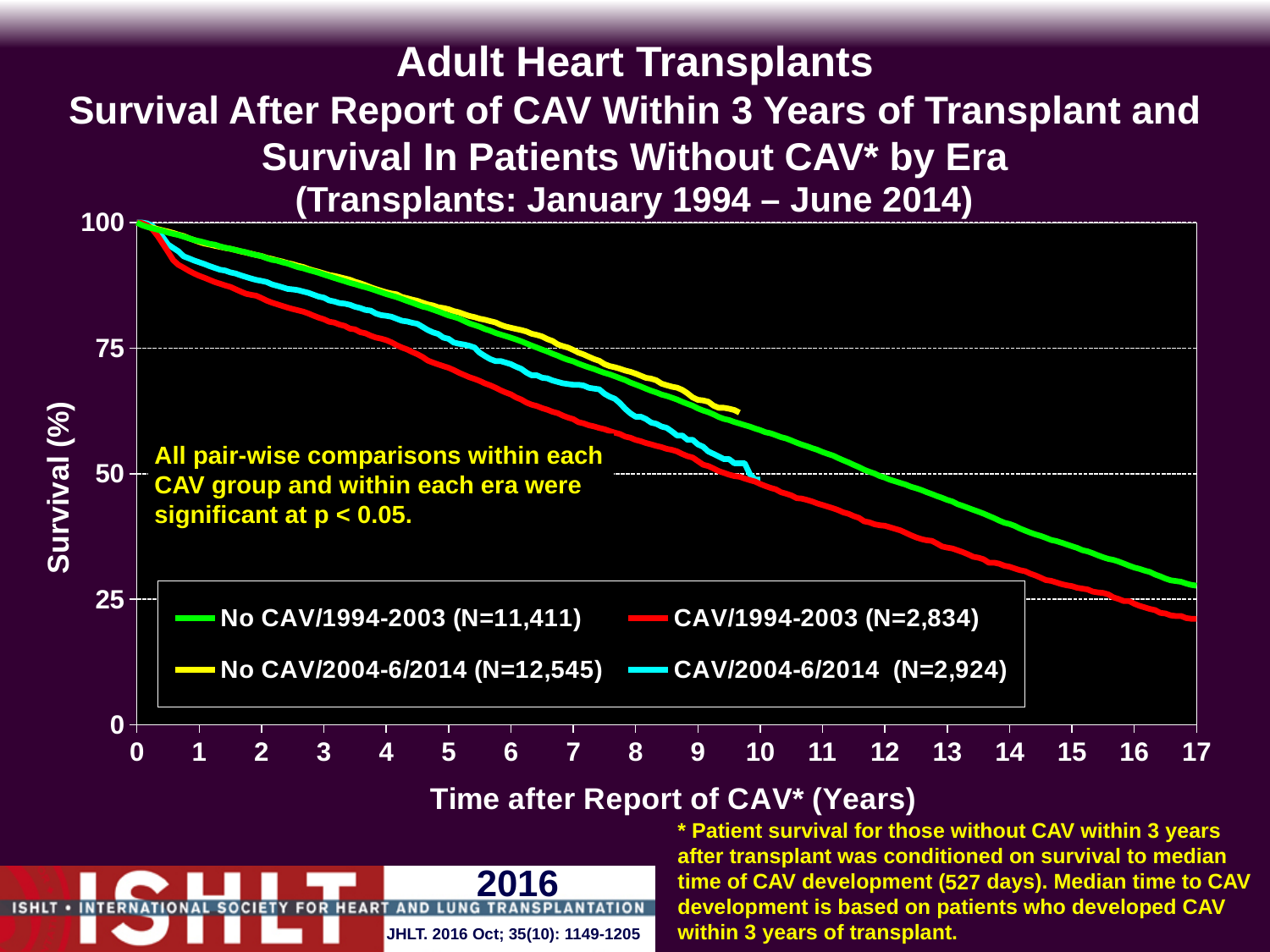
What kind of chart is shown on the slide? line chart Is the survival value for CAV/1994-2003 at 7 years greater or less than 75? less What is the label of the y axis? Survival (%) How many series does the legend list? 4 What is the N shown in the legend for the No CAV/1994-2003 series? N=11,411 Is the survival value for CAV/1994-2003 at 17 years greater or less than 25? less Is the survival value for No CAV/1994-2003 at 14 years greater or less than 50? less At 8 years, which series has the lowest survival? CAV/1994-2003 At 10 years, which series has higher survival: No CAV/1994-2003 or CAV/1994-2003? No CAV/1994-2003 Do the survival curves rise or fall as time after report of CAV increases? fall